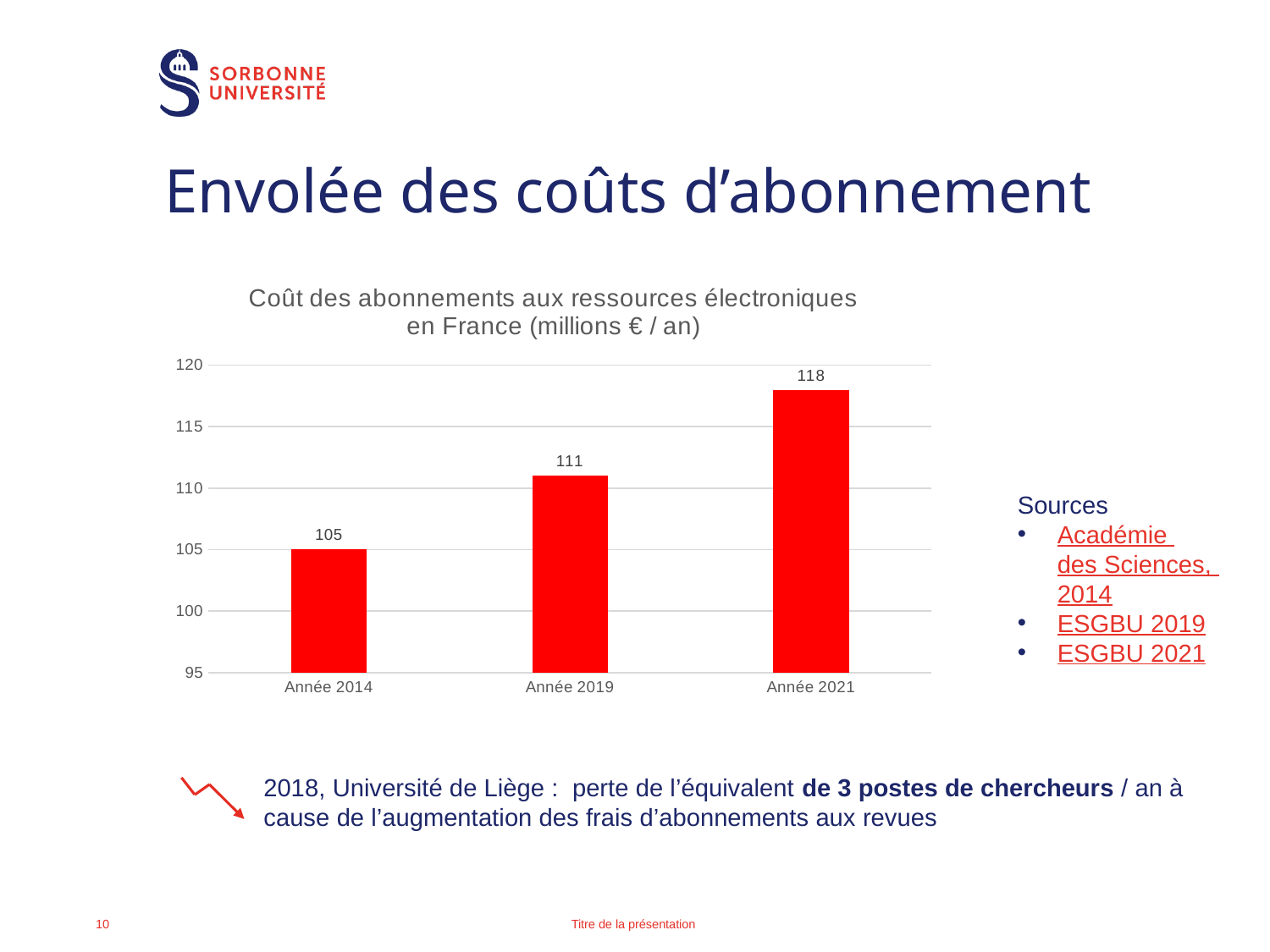
Is the value for Année 2019 greater or less than 110? greater What is the difference between the values for Année 2019 and Année 2014? 6 What is the value for Année 2019? 111 How many years are shown on the chart? 3 Which year has the lowest value? Année 2014 What is the value for Année 2021? 118 Which is larger, the value for Année 2019 or Année 2021? Année 2021 Which year has the highest value? Année 2021 What kind of chart is shown? bar chart What is the difference between the values for Année 2021 and Année 2014? 13 What is the value for Année 2014? 105 Do the values rise or fall from Année 2014 to Année 2021? rise